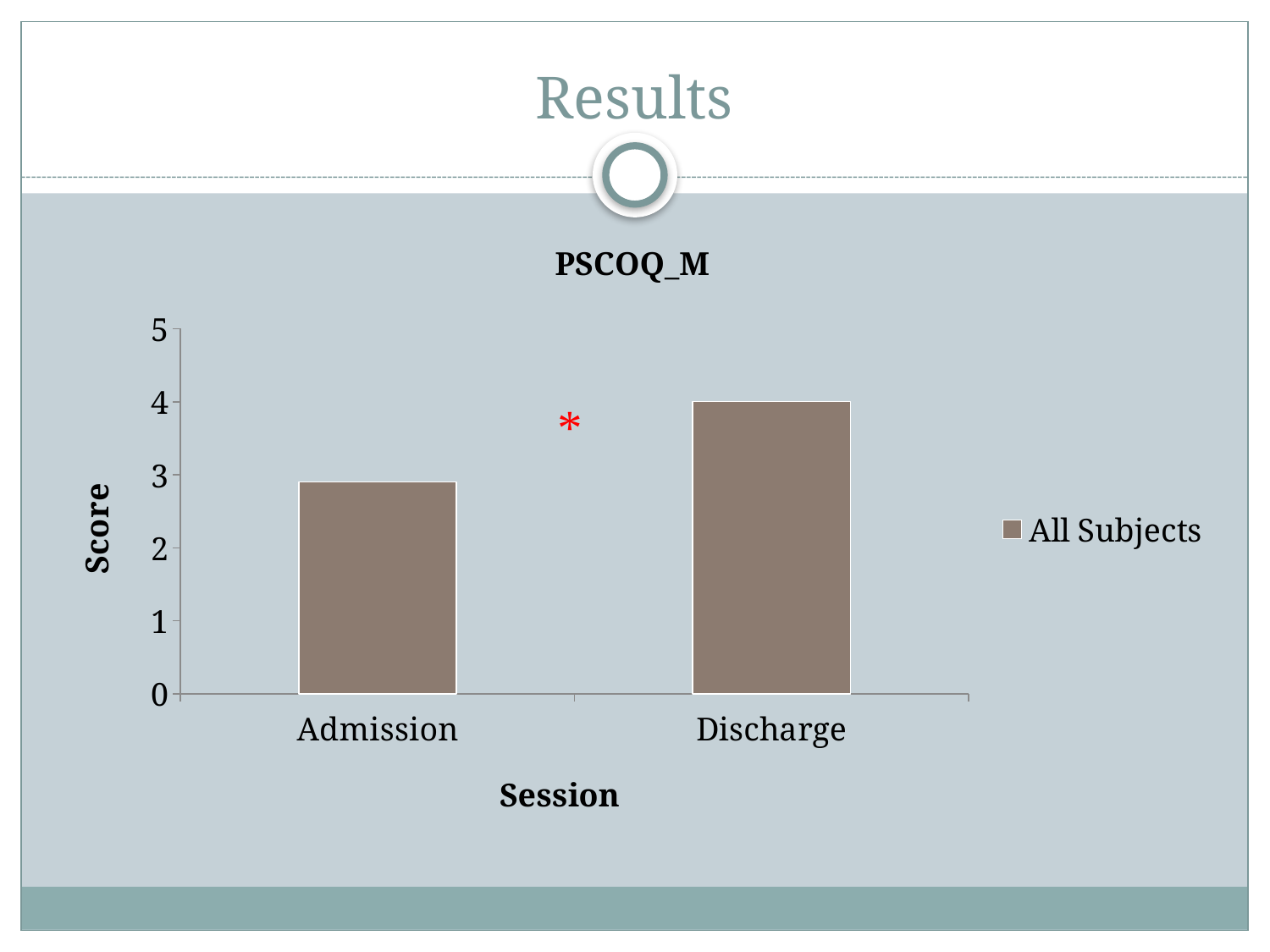
Do the scores rise or fall from Admission to Discharge? rise How many series does the chart's legend list? 1 What series name is shown in the chart's legend? All Subjects Which session has the lowest score in the chart? Admission What kind of chart is shown on the slide? bar chart What is the title of the chart? PSCOQ_M Which session has the highest score in the chart? Discharge What is the score for Discharge? 4 How many categories are shown on the x axis of the chart? 2 Is the score for Admission greater or less than 3? less Is the score for Admission greater or less than 2? greater Which is larger, the score for Admission or the score for Discharge? Discharge